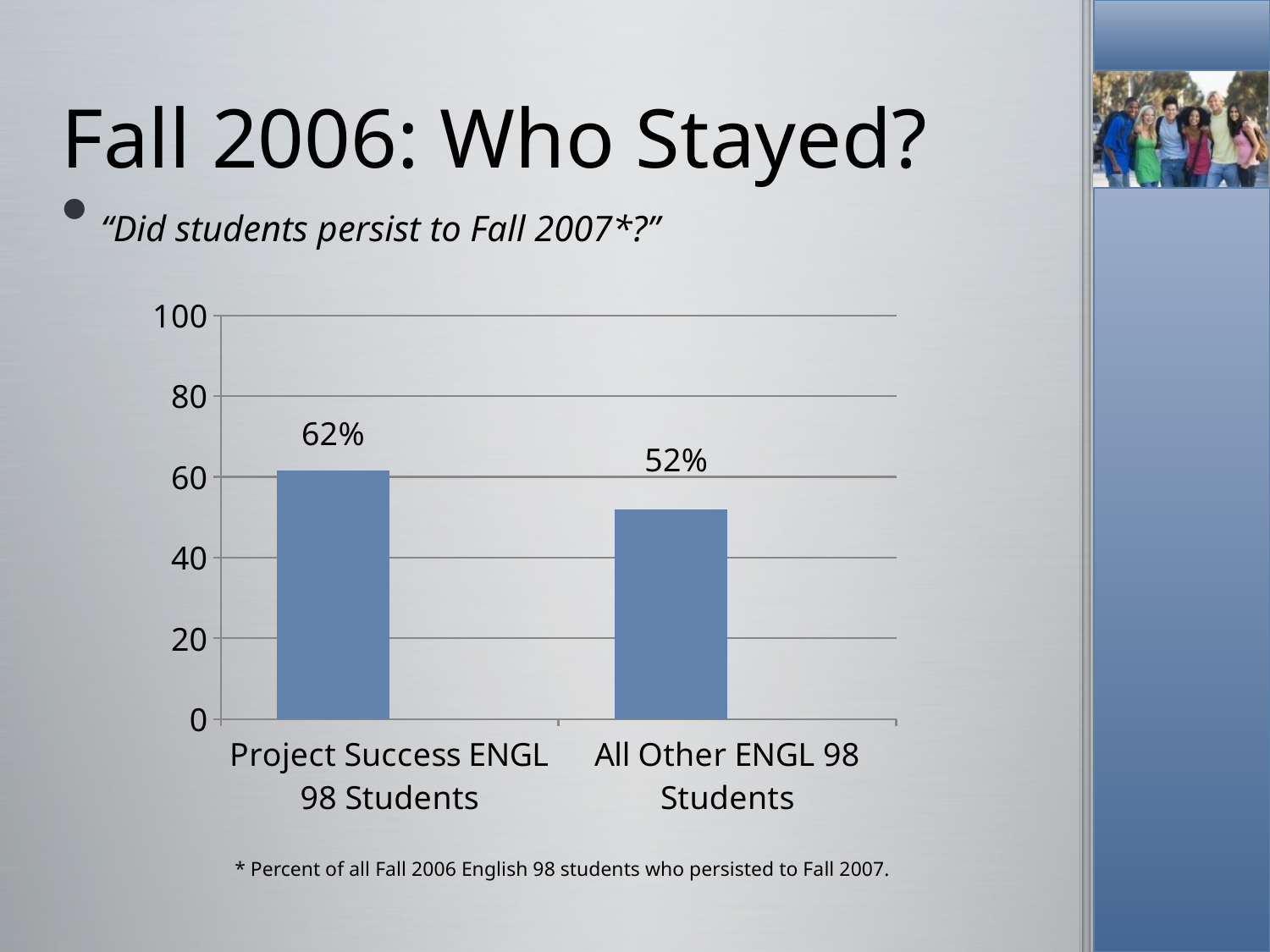
What percentage of All Other ENGL 98 Students persisted to Fall 2007? 52% What is the title of the slide containing the chart? Fall 2006: Who Stayed? What is the difference in percentage points between Project Success ENGL 98 Students and All Other ENGL 98 Students? 10 What percentage of Project Success ENGL 98 Students persisted to Fall 2007? 62% Is the value for All Other ENGL 98 Students greater or less than 60? less What is the maximum value shown on the vertical axis? 100 Which category has the lower persistence rate? All Other ENGL 98 Students Is the value for Project Success ENGL 98 Students greater or less than 40? greater Is the value for Project Success ENGL 98 Students larger or smaller than the value for All Other ENGL 98 Students? larger What kind of chart is shown on the slide? bar chart Which category has the higher persistence rate? Project Success ENGL 98 Students How many categories are shown in the chart? 2